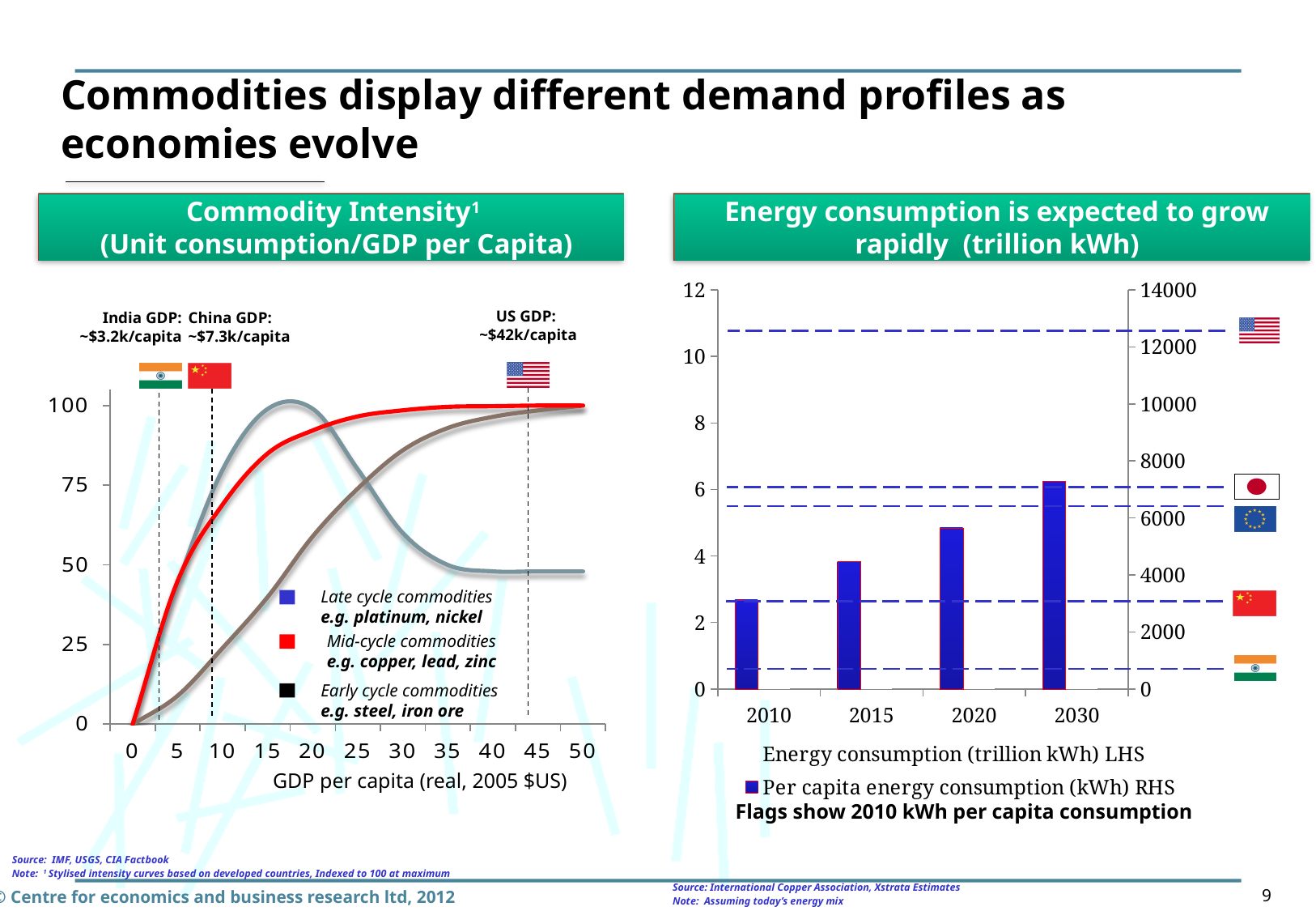
On the right-hand energy consumption chart, which year has the shortest bar? 2010 How many commodity categories does the legend of the left-hand Commodity Intensity chart list? 3 On the right-hand energy consumption chart, do the bars rise or fall from 2010 to 2030? rise What kind of chart is the left-hand chart titled 'Commodity Intensity'? line chart On the right-hand energy consumption chart, which year has the tallest bar? 2030 On the right-hand energy consumption chart, how many years are shown on the x axis? 4 What kind of chart is the right-hand chart titled 'Energy consumption is expected to grow rapidly (trillion kWh)'? bar chart How many series does the legend of the right-hand energy consumption chart list? 2 On the right-hand energy consumption chart, which bar is taller, 2015 or 2020? 2020